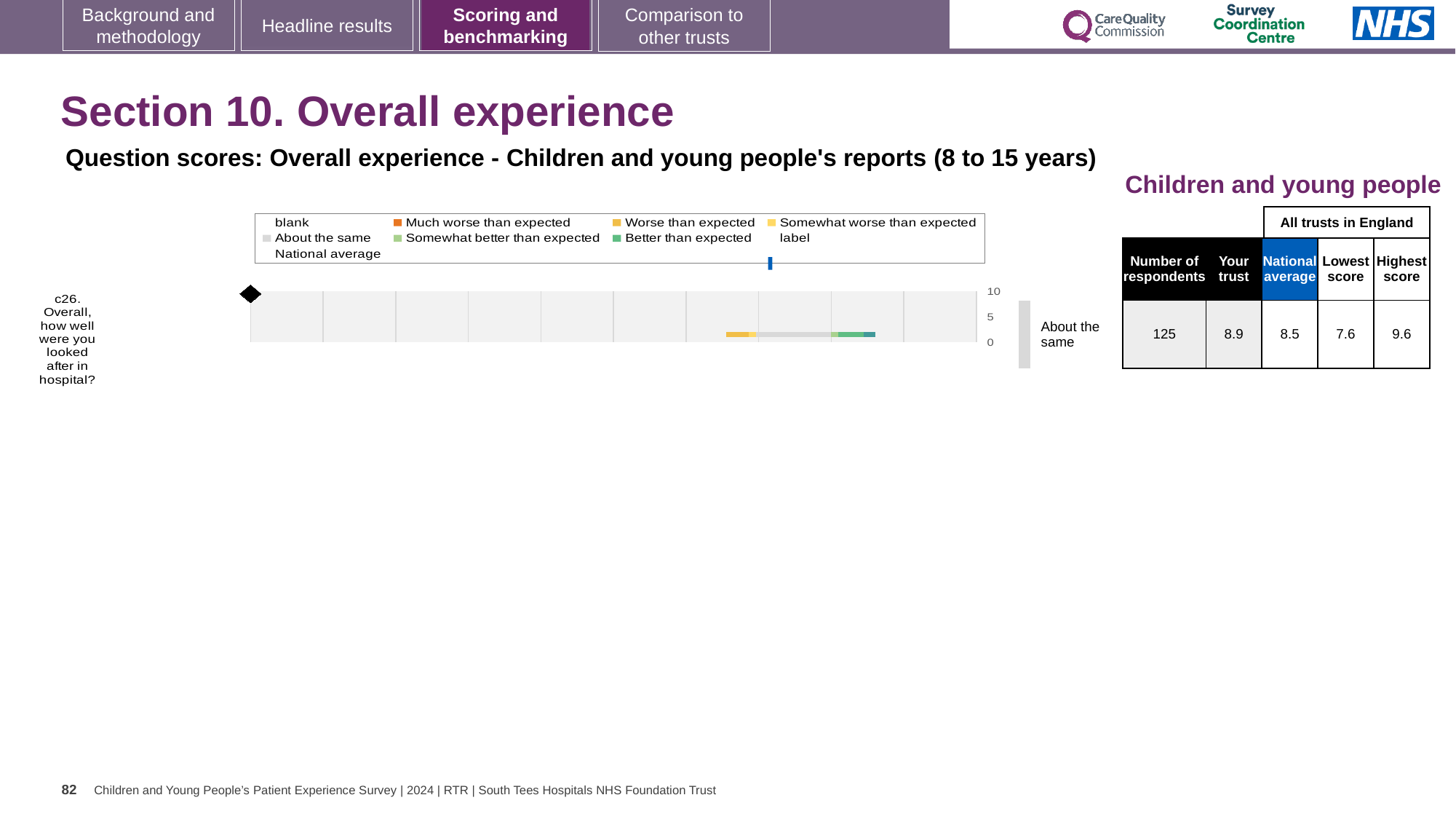
What is the highest value shown on the chart's vertical axis? 10 In the table beside the chart, what is the 'Your trust' score for c26? 8.9 In the table beside the chart, what is the national average score for c26? 8.5 Which is larger for c26, the 'Your trust' score or the national average? Your trust What kind of chart is used to show the question score for c26? bar chart How many survey questions are plotted in the chart? 1 What benchmark category is shown next to the chart for question c26? About the same Which legend entry is shown in blue in the chart's legend? National average In the table beside the chart, how many respondents answered question c26? 125 In the table beside the chart, what is the lowest score among all trusts in England for c26? 7.6 In the table beside the chart, what is the highest score among all trusts in England for c26? 9.6 What is the difference between the highest score and the lowest score for c26 in the table beside the chart? 2.0